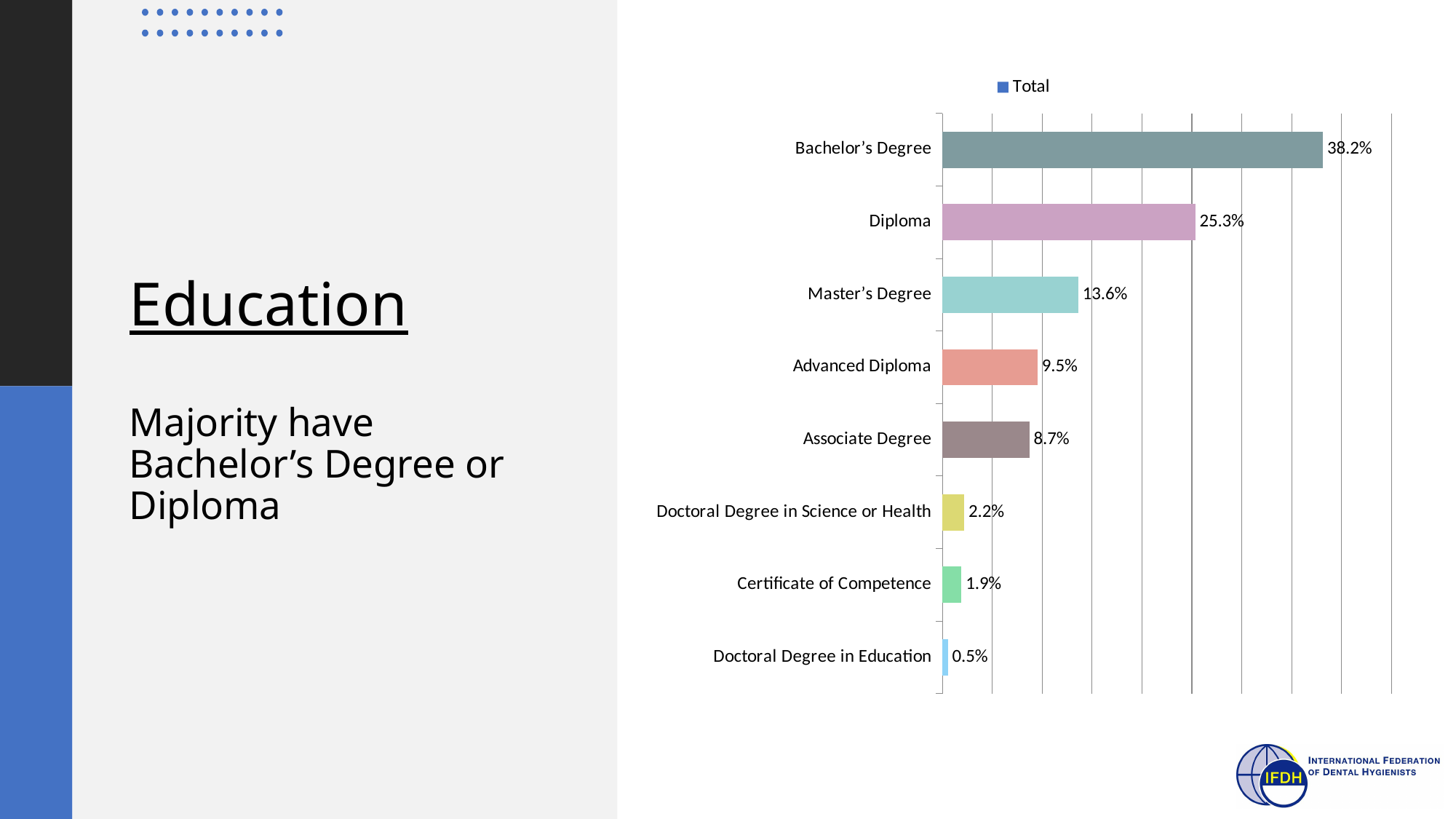
What is the value for Master's Degree? 13.6% What is the difference between the values for Bachelor's Degree and Diploma? 12.9% What is the value for Bachelor's Degree? 38.2% How many categories are shown in the chart? 8 What is the difference between the values for Advanced Diploma and Associate Degree? 0.8% Which category has the lowest value? Doctoral Degree in Education Which category has the highest value? Bachelor's Degree What is the value for Diploma? 25.3% What is the value for Doctoral Degree in Science or Health? 2.2% What series name does the legend show? Total What kind of chart is shown on the slide? Bar chart Which is larger, the value for Master's Degree or the value for Advanced Diploma? Master's Degree